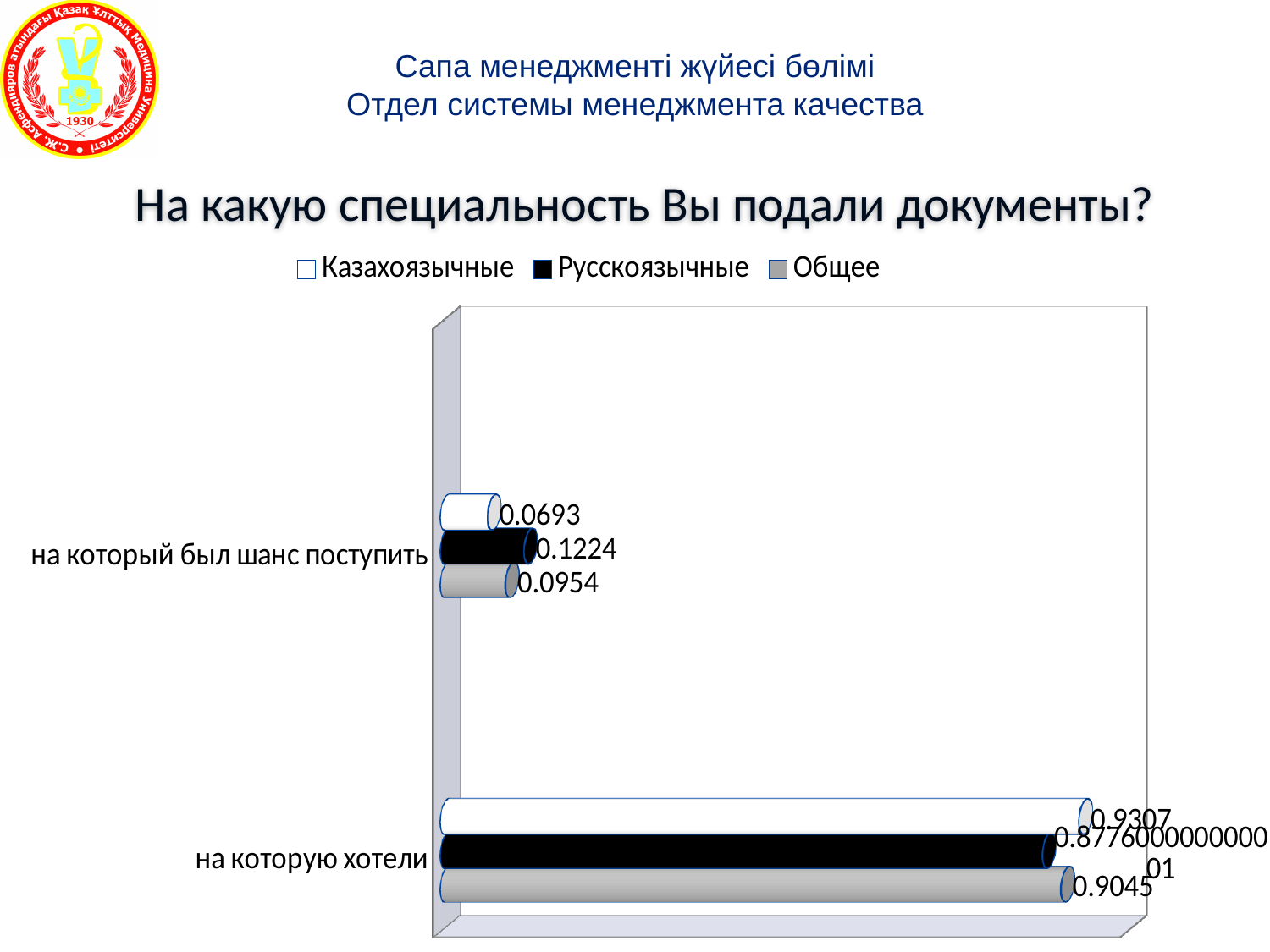
What is the value for Казахоязычные in the category 'на который был шанс поступить'? 0.0693 What is the difference between the Русскоязычные and Казахоязычные values in the category 'на который был шанс поступить'? 0.0531 What is the value for Русскоязычные in the category 'на который был шанс поступить'? 0.1224 How many categories are shown on the chart? 2 What is the value for Общее in the category 'на который был шанс поступить'? 0.0954 What is the value for Общее in the category 'на которую хотели'? 0.9045 How many series does the legend list? 3 What type of chart is shown on the slide? bar chart What is the title of the chart? На какую специальность Вы подали документы? Which series has the highest value in the category 'на который был шанс поступить'? Русскоязычные What is the value for Казахоязычные in the category 'на которую хотели'? 0.9307 Which series has the lowest value in the category 'на которую хотели'? Русскоязычные